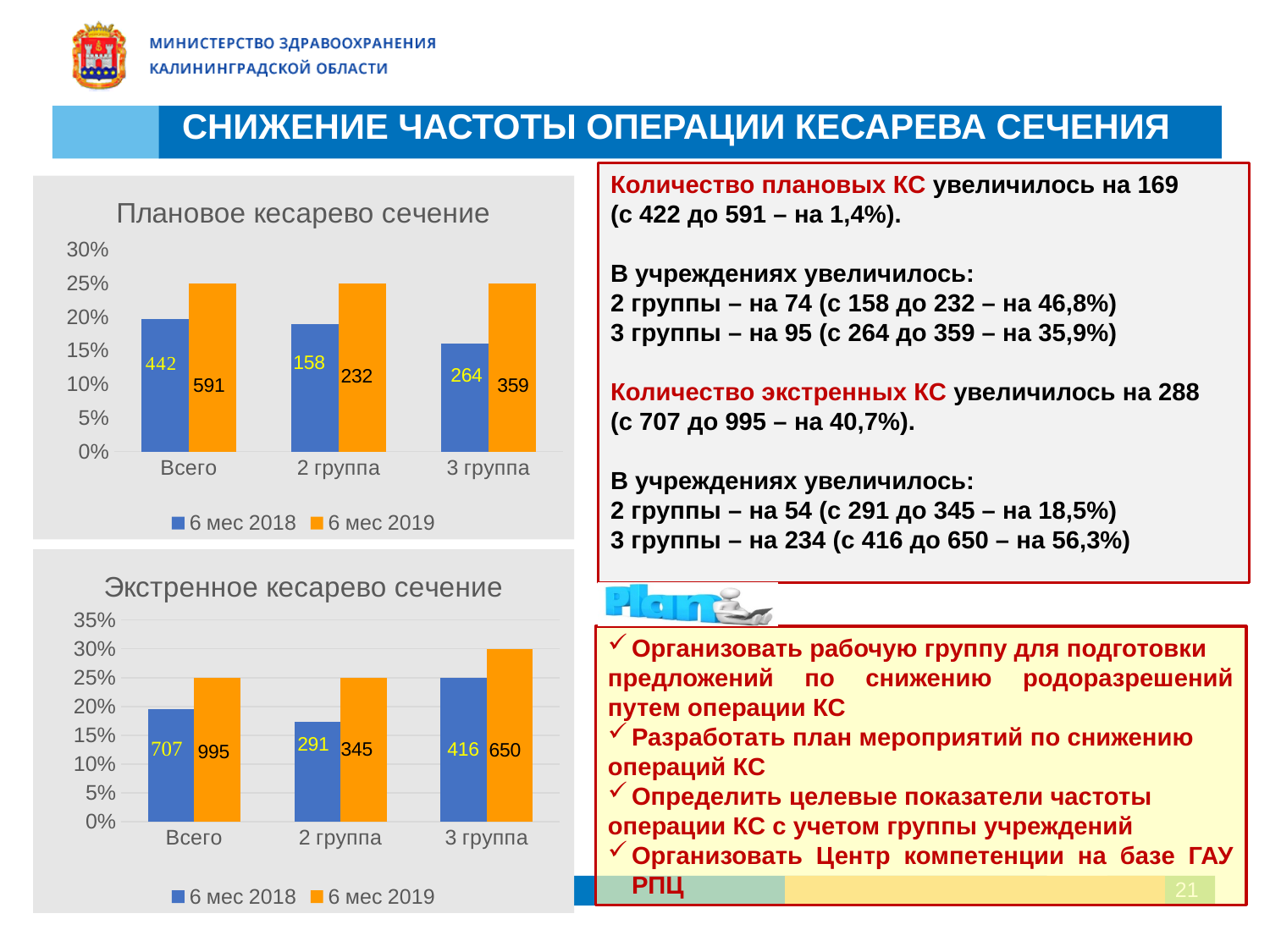
In the 'Плановое кесарево сечение' chart, which category has the shortest '6 мес 2018' bar? 3 группа In the 'Экстренное кесарево сечение' chart, is the '6 мес 2018' bar for 'Всего' greater or less than 25%? less In the 'Экстренное кесарево сечение' chart, what data label is shown on the '6 мес 2018' bar for 'Всего'? 707 How many categories are shown on the x axis of the 'Экстренное кесарево сечение' chart? 3 In the 'Экстренное кесарево сечение' chart, what data label is shown on the '6 мес 2019' bar for '3 группа'? 650 How many series does the legend of the 'Плановое кесарево сечение' chart list? 2 What type of chart is the 'Плановое кесарево сечение' chart? bar chart In the 'Экстренное кесарево сечение' chart, which category has the tallest '6 мес 2019' bar? 3 группа In the 'Плановое кесарево сечение' chart, what data label is shown on the '6 мес 2018' bar for '2 группа'? 158 In the 'Плановое кесарево сечение' chart, what is the difference between the data labels for '3 группа' in 6 мес 2019 and 6 мес 2018? 95 In the 'Экстренное кесарево сечение' chart, what is the difference between the data labels for 'Всего' in 6 мес 2019 and 6 мес 2018? 288 In the 'Плановое кесарево сечение' chart, what data label is shown on the '6 мес 2019' bar for 'Всего'? 591